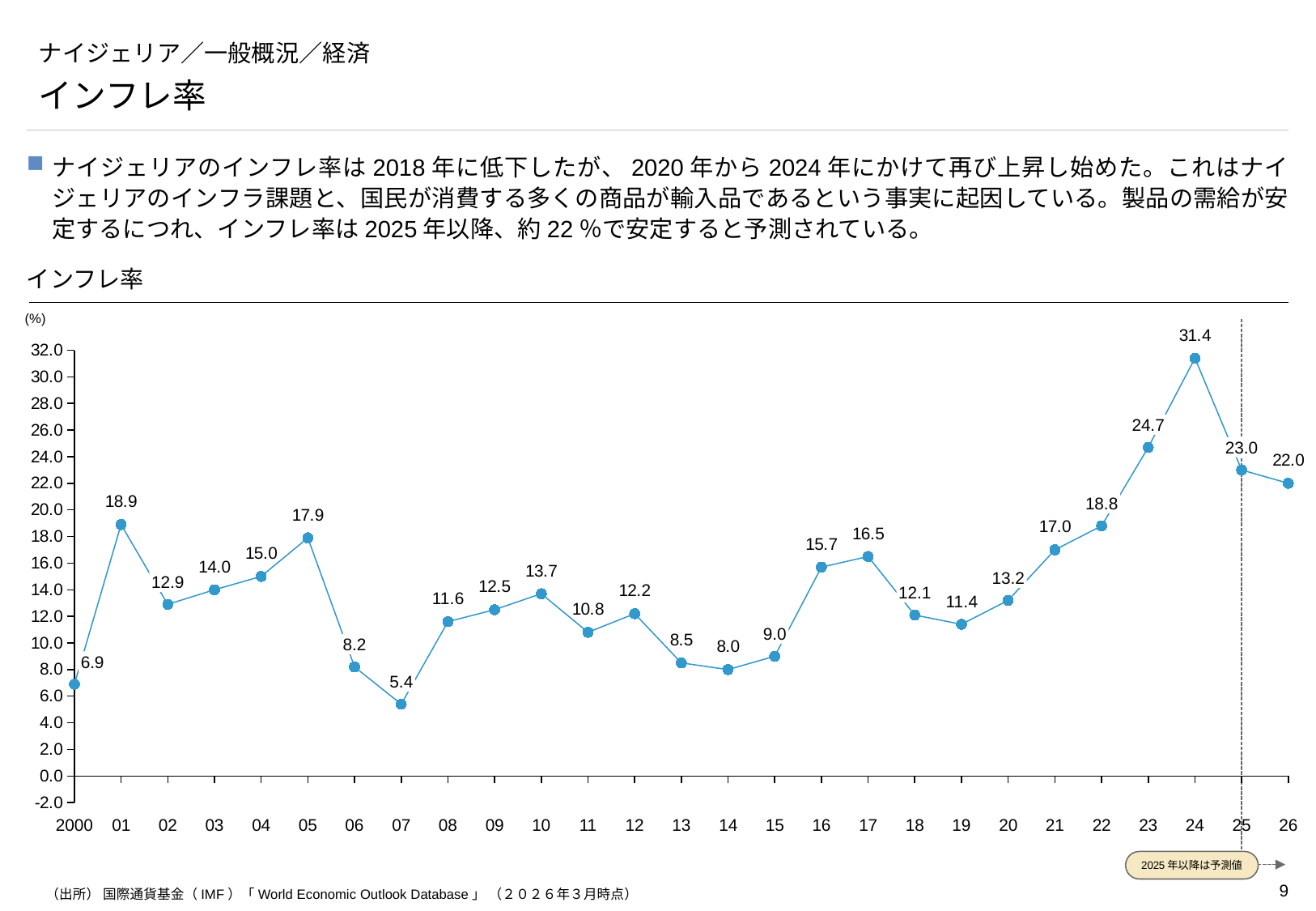
Which year has a higher inflation rate, 2001 or 2005? 2001 What kind of chart is shown on the slide? Line chart What unit is shown on the y axis of the chart? % Which year has the highest inflation rate on the chart? 2024 From which year onward are the values marked as forecasts (予測値)? 2025 What is the inflation rate shown for 2007? 5.4 Do the values rise or fall from 2019 to 2024? Rise How many data points are plotted on the chart? 27 Which year has the lowest inflation rate on the chart? 2007 What is the inflation rate shown for 2024? 31.4 What is the inflation rate shown for 2018? 12.1 What is the difference between the inflation rate in 2024 and in 2025? 8.4